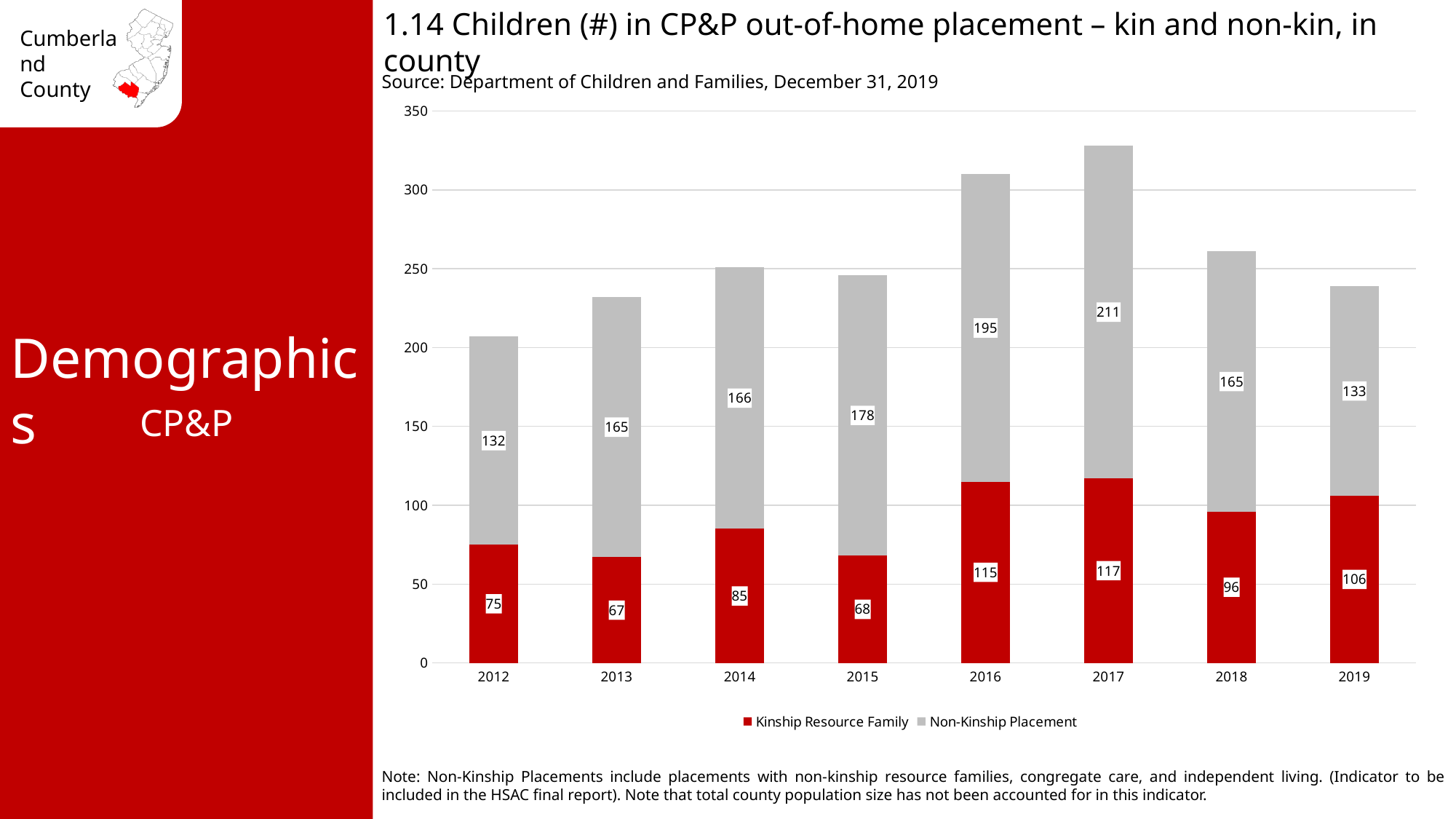
How many series does the legend list? 2 Which is larger: the Kinship Resource Family value in 2018 or in 2019? 2019 What kind of chart is shown on the slide? Stacked bar chart What is the value for Non-Kinship Placement in 2012? 132 What is the value for Kinship Resource Family in 2016? 115 What is the total of the stacked bar for 2012? 207 What is the difference between the Non-Kinship Placement values for 2016 and 2019? 62 Which year has the lowest Kinship Resource Family value? 2013 How many years are shown on the x axis? 8 What is the total of the stacked bar for 2017? 328 What is the value for Non-Kinship Placement in 2017? 211 Which year has the highest Non-Kinship Placement value? 2017